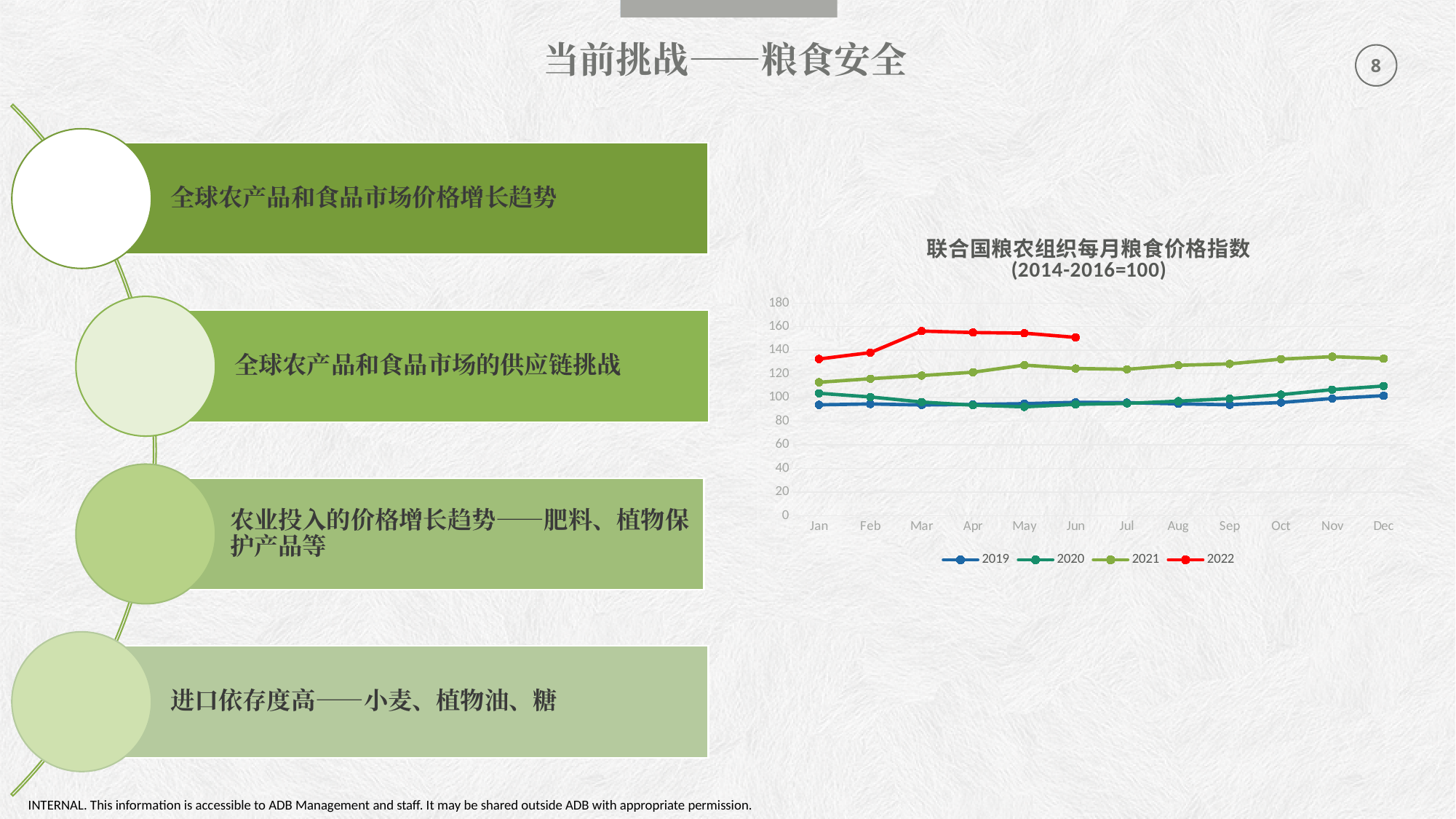
Is the value for 2021 in Dec greater or less than 120? greater Which series has the highest value in Mar? 2022 Is the value for 2019 in Jan greater or less than 100? less Is the value for 2022 in Mar greater or less than 140? greater What colour is the line for the 2022 series? red How many data points does the 2022 series have? 6 How many months are shown on the x axis of the chart? 12 How many series does the chart legend list? 4 What kind of chart is shown on the slide? line chart Does the 2021 series generally rise or fall from Jan to Dec? rise In Jan, which series has the larger value, 2021 or 2022? 2022